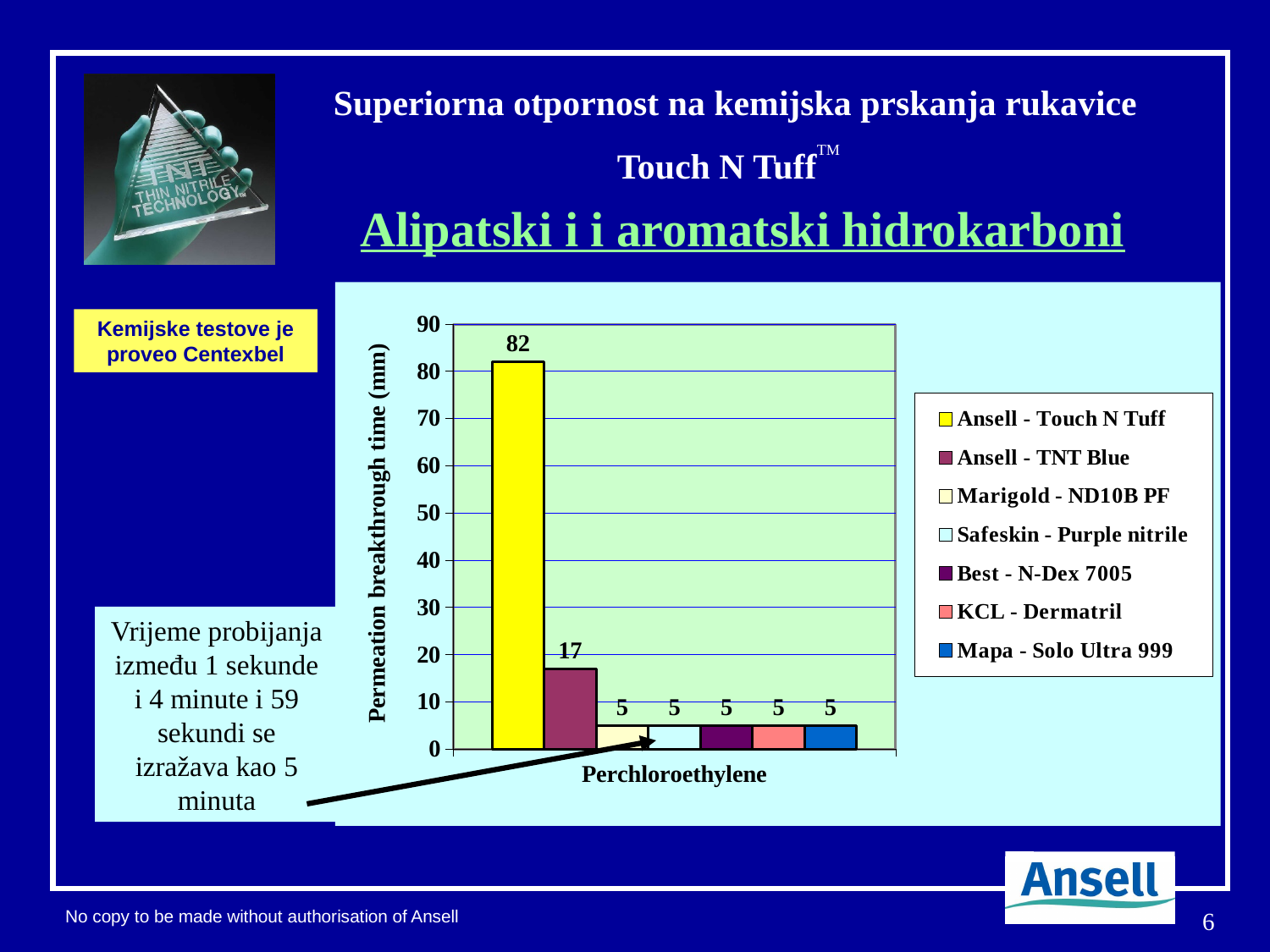
What is the permeation breakthrough time for Ansell - Touch N Tuff on Perchloroethylene? 82 Which glove has the highest permeation breakthrough time on Perchloroethylene? Ansell - Touch N Tuff What is the difference in permeation breakthrough time between Ansell - Touch N Tuff and Ansell - TNT Blue? 65 Which has a larger permeation breakthrough time, Ansell - TNT Blue or Best - N-Dex 7005? Ansell - TNT Blue What chemical is named on the horizontal axis of the chart? Perchloroethylene What kind of chart is shown on the slide? Bar chart What is the label on the vertical axis of the chart? Permeation breakthrough time (mm) How many series does the legend list? 7 Is the value for Ansell - Touch N Tuff greater or less than 80? greater What is the difference in permeation breakthrough time between Ansell - TNT Blue and KCL - Dermatril? 12 What is the permeation breakthrough time for Ansell - TNT Blue on Perchloroethylene? 17 What is the permeation breakthrough time for Mapa - Solo Ultra 999 on Perchloroethylene? 5